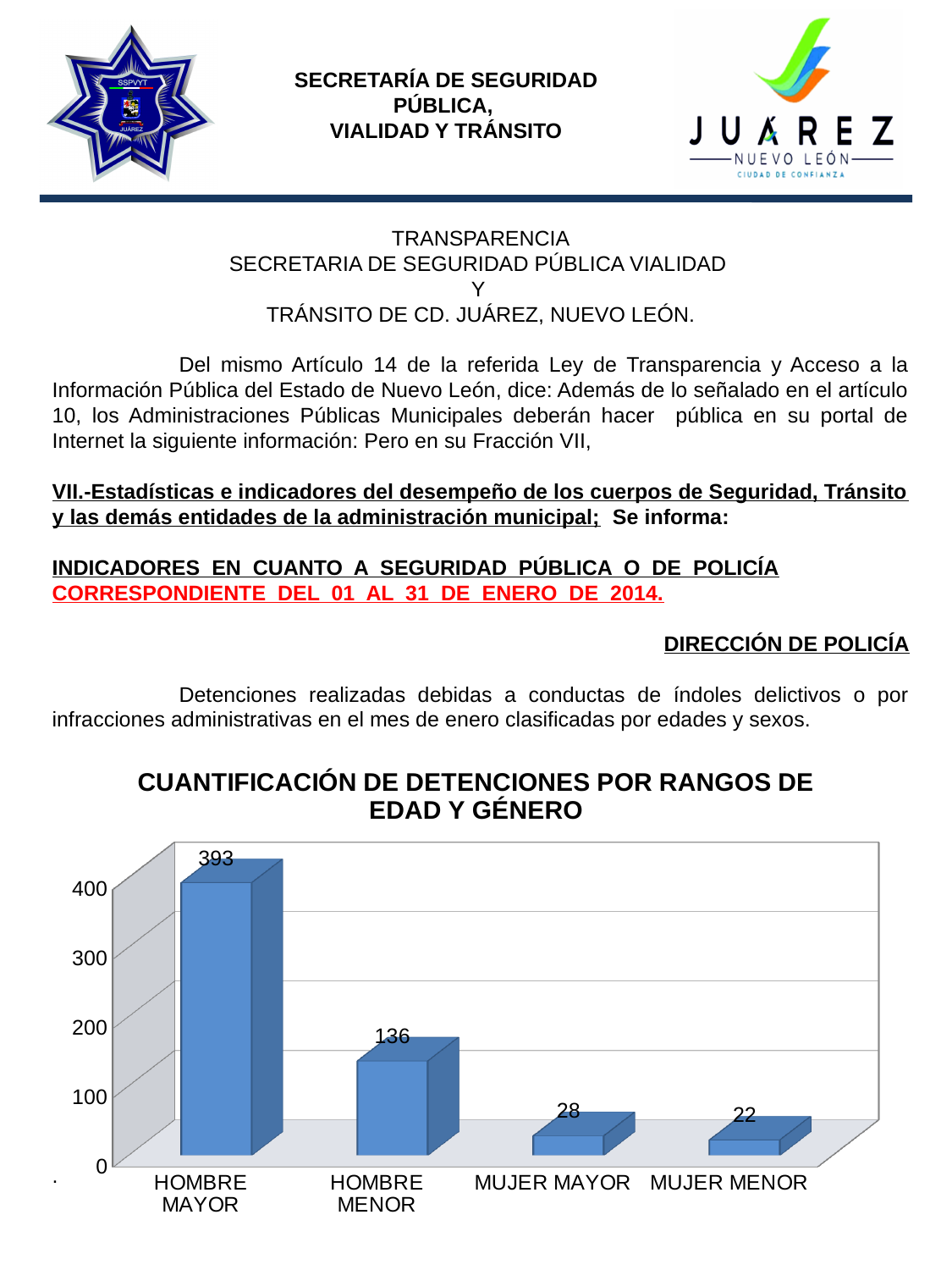
What is the value for HOMBRE MENOR? 136 Which category has the highest value? HOMBRE MAYOR Which category has the lowest value? MUJER MENOR What is the title of the chart? CUANTIFICACIÓN DE DETENCIONES POR RANGOS DE EDAD Y GÉNERO What is the value for HOMBRE MAYOR? 393 What is the difference between the values for HOMBRE MAYOR and HOMBRE MENOR? 257 What is the value for MUJER MENOR? 22 How many categories are shown on the x axis? 4 Which is larger, the value for MUJER MAYOR or MUJER MENOR? MUJER MAYOR What kind of chart is shown on the slide? bar chart Is the value for HOMBRE MENOR greater or less than 100? greater What is the value for MUJER MAYOR? 28